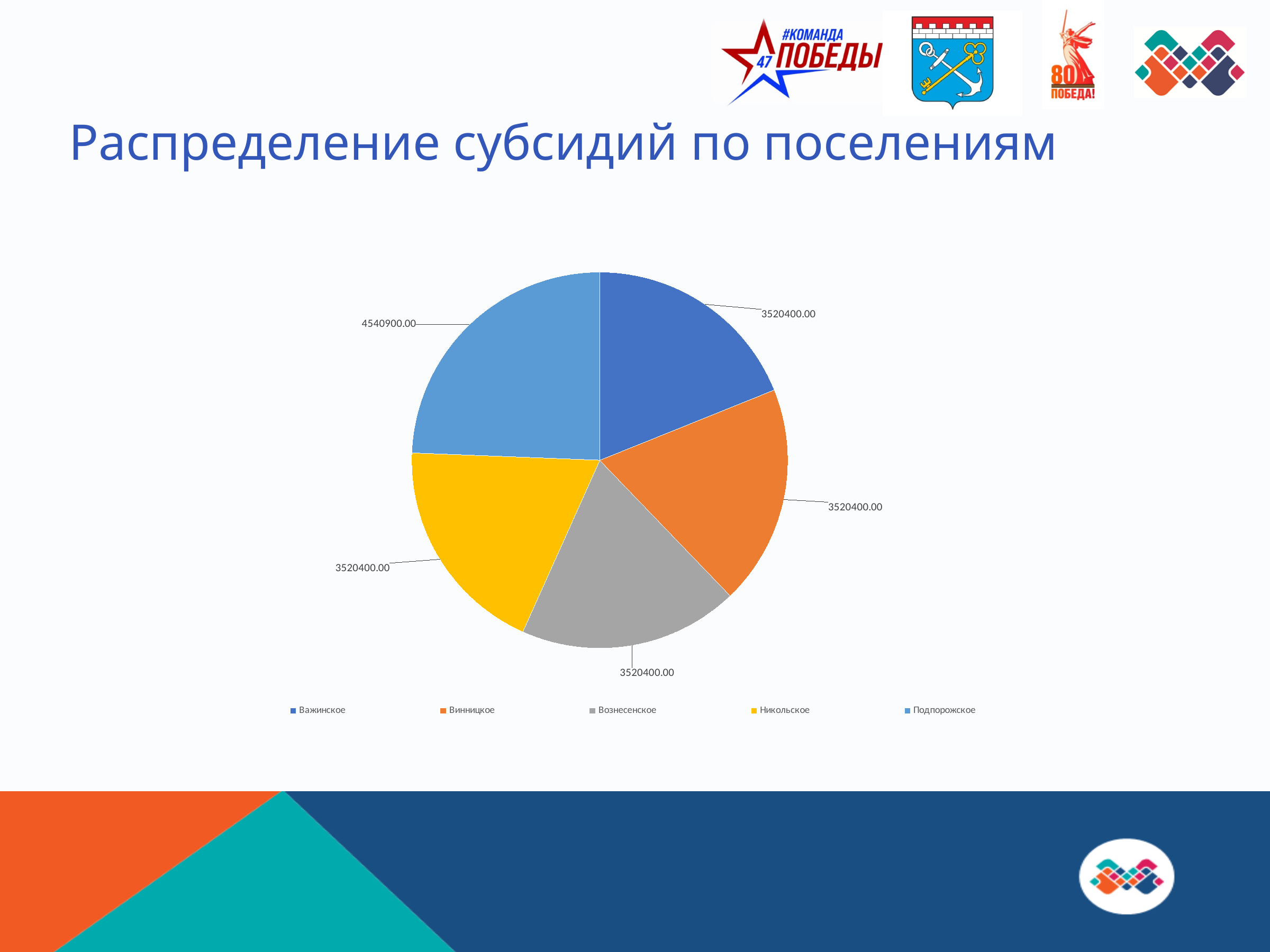
What is the difference between the values for Подпорожское and Вознесенское? 1020500.00 Which settlement received the largest subsidy? Подпорожское What is the value for Никольское? 3520400.00 What type of chart is shown on the slide? pie chart What is the title of the chart? Распределение субсидий по поселениям What is the value for Важинское? 3520400.00 What is the value for Подпорожское? 4540900.00 What is the total of all slices in the pie chart? 18622500.00 What colour is the slice for Никольское? yellow How many slices does the pie chart have? 5 How many entries does the legend list? 5 Which is larger, the value for Подпорожское or the value for Винницкое? Подпорожское